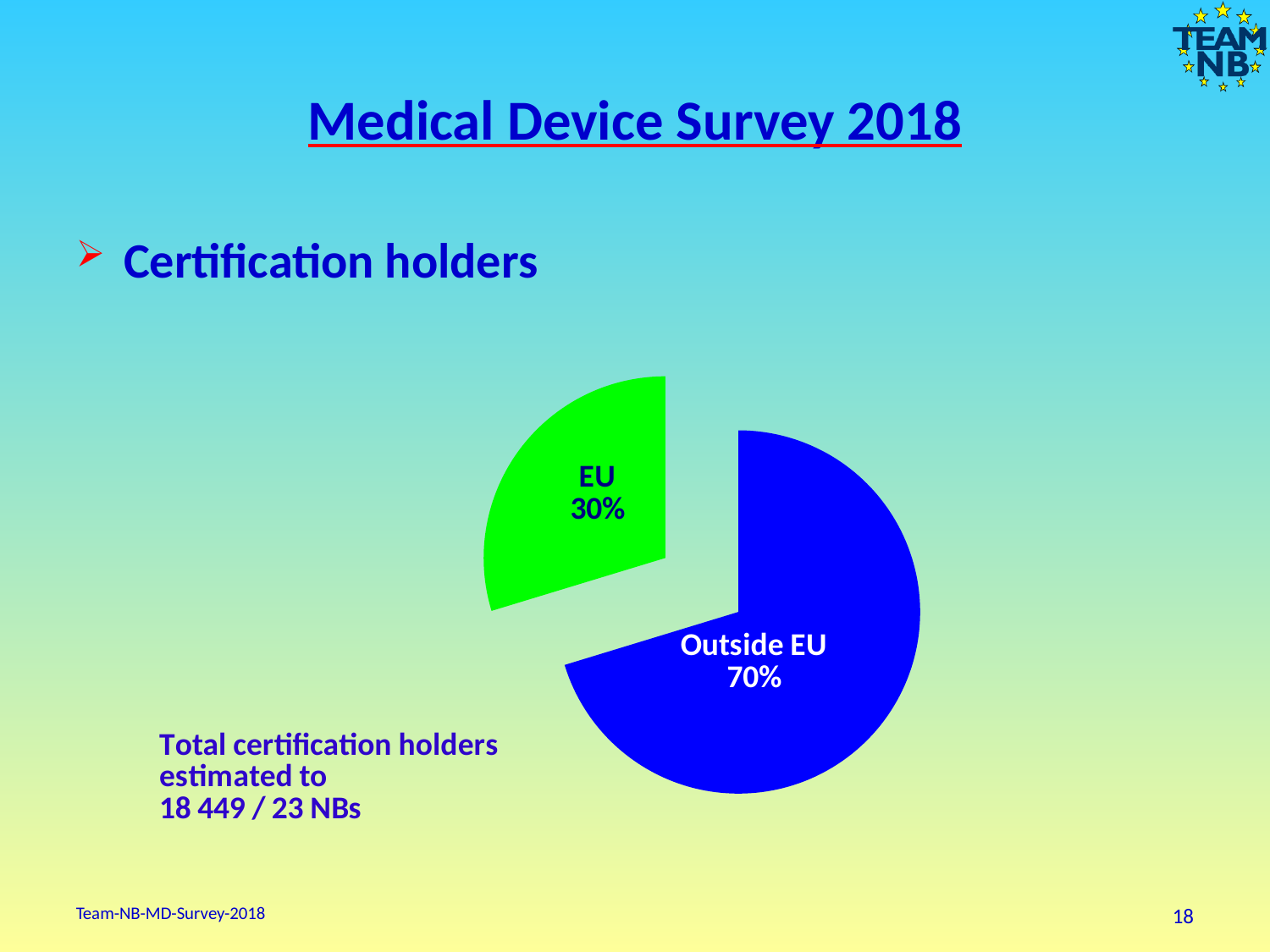
What colour is the Outside EU slice of the pie? blue Which slice of the pie is the largest? Outside EU Which slice of the pie is the smallest? EU What share of certification holders is from the EU? 30% What kind of chart is shown on the slide? pie chart Which is larger, the EU slice or the Outside EU slice? Outside EU What is the difference in percentage points between the Outside EU and EU slices? 40 percentage points What share of certification holders is from outside the EU? 70% How many slices does the pie chart have? 2 What colour is the EU slice of the pie? green What is the total number of certification holders estimated to be, according to the text next to the chart? 18 449 / 23 NBs